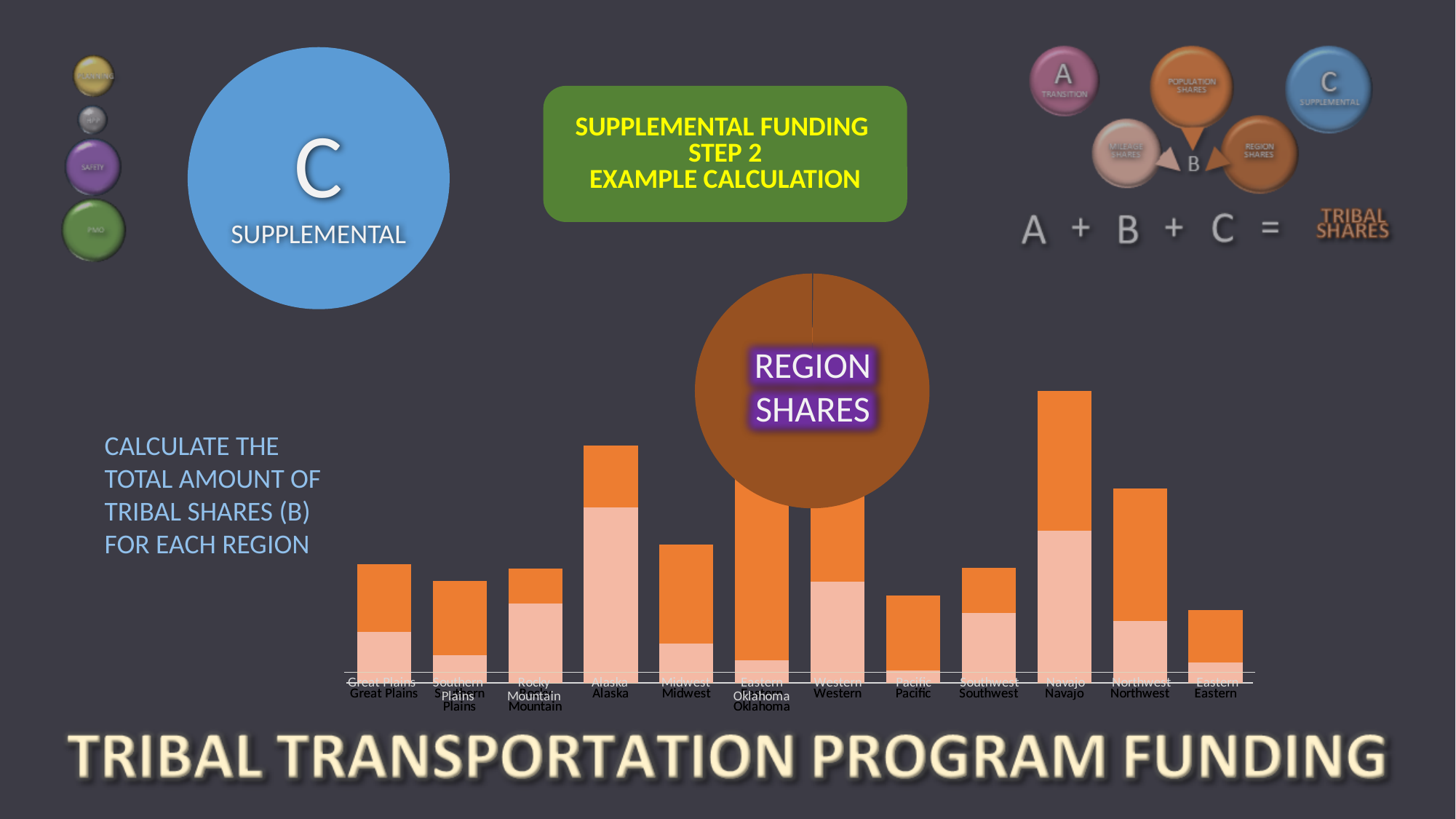
What label appears in the brown circle above the bar chart? REGION SHARES Which bar is taller, Navajo or Alaska? Navajo What kind of chart is shown at the bottom of the slide? Stacked bar chart Which bar is taller, Navajo or Northwest? Navajo How many regions are shown along the x axis of the bar chart? 12 Which bar is taller, Southwest or Eastern? Southwest How many coloured segments make up each bar in the chart? 2 Which region has the shortest bar in the chart? Eastern